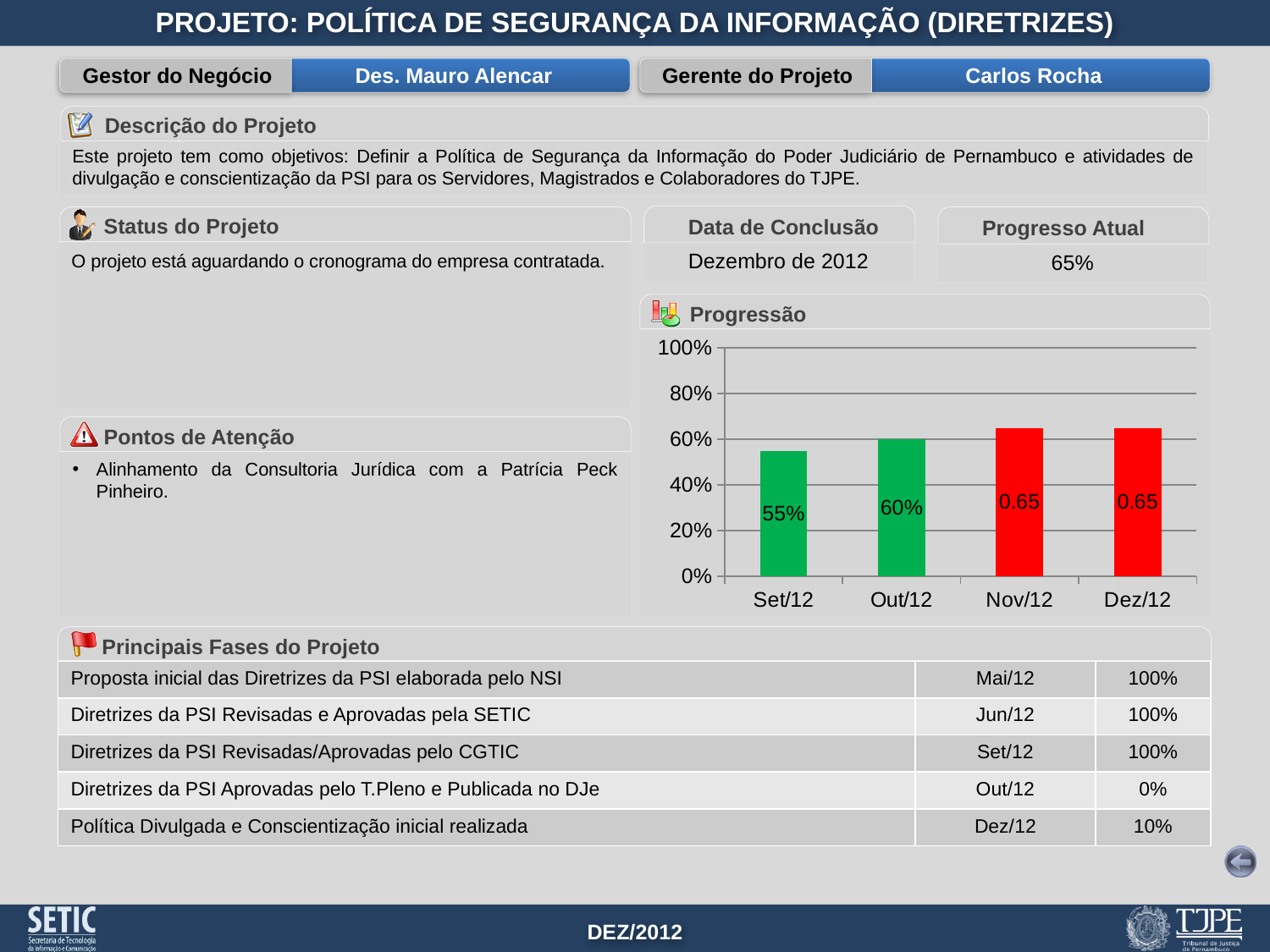
What data label is shown on the Dez/12 bar in the Progressão chart? 0.65 In the Progressão chart, which is larger: the value for Set/12 or the value for Out/12? Out/12 Which month has the lowest value in the Progressão chart? Set/12 Do the values in the Progressão chart rise or fall from Set/12 to Dez/12? rise How many months are shown on the x axis of the Progressão chart? 4 What is the value for Out/12 in the Progressão chart? 60% What colour are the Nov/12 and Dez/12 bars in the Progressão chart? red In the Progressão chart, is the value for Nov/12 greater or less than 80%? less What data label is shown on the Nov/12 bar in the Progressão chart? 0.65 What kind of chart is the Progressão chart? bar chart What is the value for Set/12 in the Progressão chart? 55% What is the difference between the values for Out/12 and Set/12 in the Progressão chart? 5%